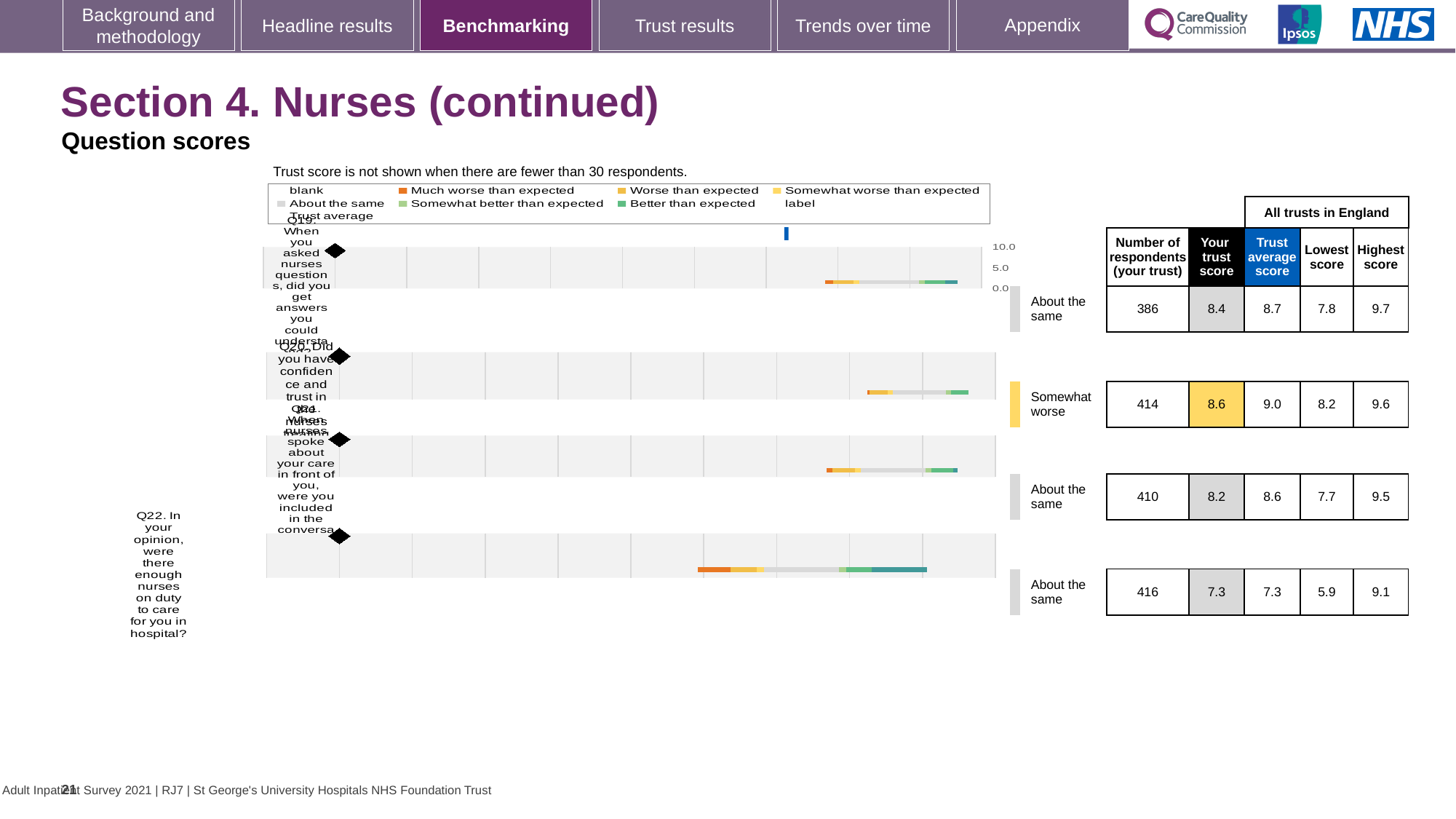
Which question has the highest trust score? Q20 What kind of chart is used to show the question scores on this slide? bar chart Which question is rated 'Somewhat worse' than expected? Q20 What is the trust average score for Q20 (did you have confidence and trust in the nurses)? 9.0 How many respondents answered Q21 at this trust? 410 How many questions (categories) are plotted in the chart? 4 What is the difference between the trust average score and this trust's score for Q19? 0.3 What is the highest score across all trusts in England for Q19? 9.7 What is the trust score for Q22 (were there enough nurses on duty to care for you in hospital)? 7.3 Which is larger for Q21: the trust score or the trust average score? Trust average score What is the lowest score across all trusts in England for Q22? 5.9 Which question has the lowest trust score? Q22